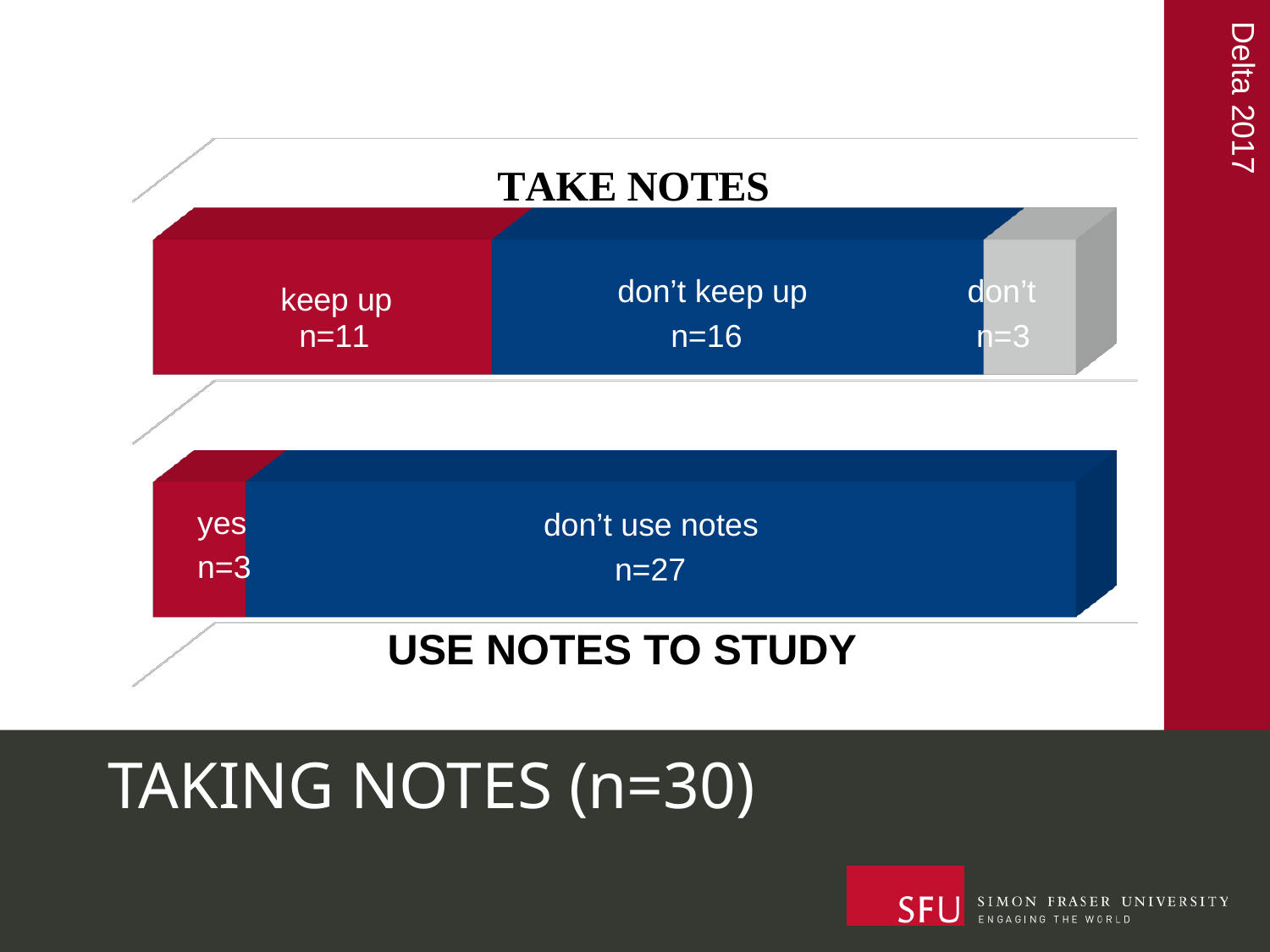
How many segments does the TAKE NOTES bar have? 3 In the TAKE NOTES chart, what is the total of all segments in the bar? 30 In the TAKE NOTES chart, what is the value for the 'don't keep up' segment? n=16 In the TAKE NOTES chart, what is the difference between the 'don't keep up' and 'keep up' values? 5 In the USE NOTES TO STUDY chart, what is the value for the 'don't use notes' segment? n=27 In the TAKE NOTES chart, which segment has the smallest value? don't In the TAKE NOTES chart, what is the value for the 'keep up' segment? n=11 In the TAKE NOTES chart, what is the value for the 'don't' segment? n=3 In the TAKE NOTES chart, which segment has the largest value? don't keep up In the USE NOTES TO STUDY chart, what is the value for the 'yes' segment? n=3 In the USE NOTES TO STUDY chart, what is the difference between the 'don't use notes' and 'yes' values? 24 What kind of chart is used on this slide? Stacked bar chart